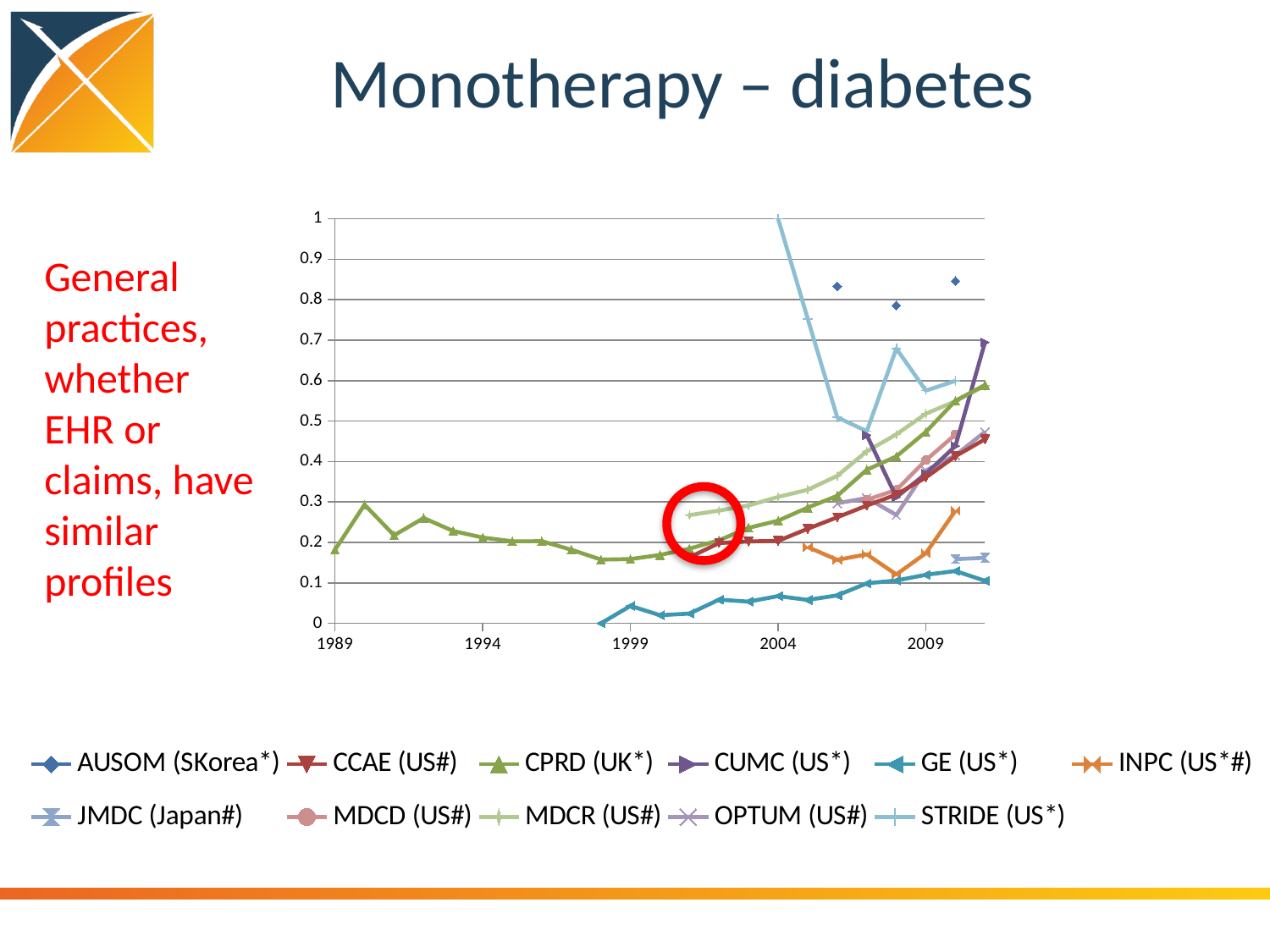
Does the STRIDE (US*) line rise or fall between 2004 and 2006? fall Which series reaches the highest value anywhere on the chart? STRIDE (US*) In 2006, which is larger: the value for AUSOM (SKorea*) or the value for GE (US*)? AUSOM (SKorea*) What is the title of the slide containing the chart? Monotherapy – diabetes What kind of chart is shown on the slide? line chart Does the CPRD (UK*) line rise or fall between 2000 and 2011? rise Is the value for GE (US*) in 2009 greater or less than 0.2? less Is the value for STRIDE (US*) in 2004 greater or less than 0.9? greater Is the value for CUMC (US*) in 2011 greater or less than 0.6? greater Which series has the lowest values in 2009? GE (US*) How many series does the chart legend list? 11